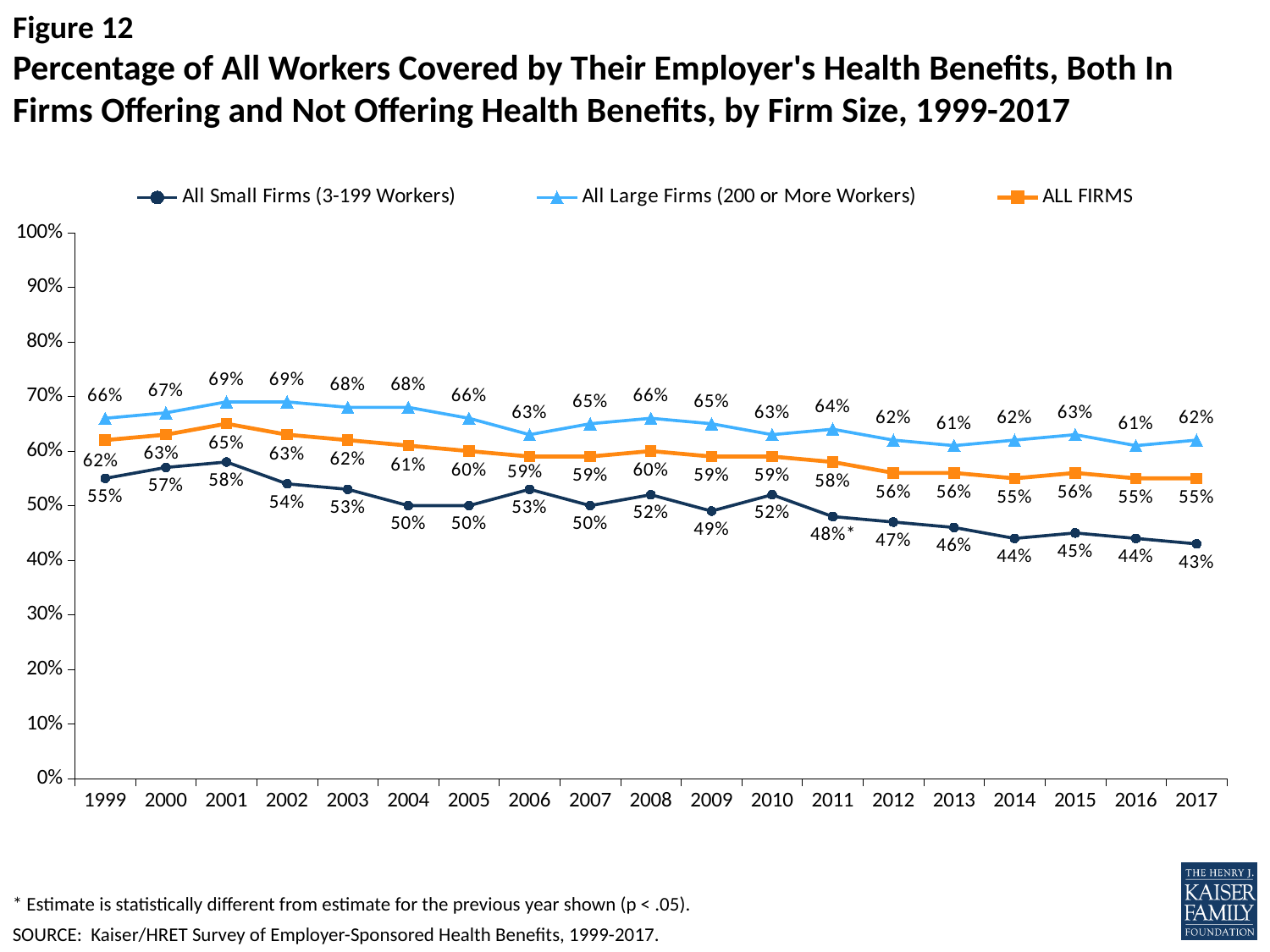
Which is larger in 2010: the value for All Large Firms (200 or More Workers) or the value for All Small Firms (3-199 Workers)? All Large Firms (200 or More Workers) How many years are plotted along the x axis? 19 What type of chart is shown on the slide? line chart What is the value for ALL FIRMS in 2001? 65% What is the value for All Large Firms (200 or More Workers) in 2006? 63% In which year is the All Small Firms (3-199 Workers) value lowest? 2017 Which series is drawn with orange square markers? ALL FIRMS What is the difference between the All Large Firms (200 or More Workers) value and the All Small Firms (3-199 Workers) value in 2017? 19% How many series does the legend list? 3 Does the All Small Firms (3-199 Workers) series generally rise or fall from 1999 to 2017? fall In which year is the ALL FIRMS value highest? 2001 What is the value for All Small Firms (3-199 Workers) in 2017? 43%